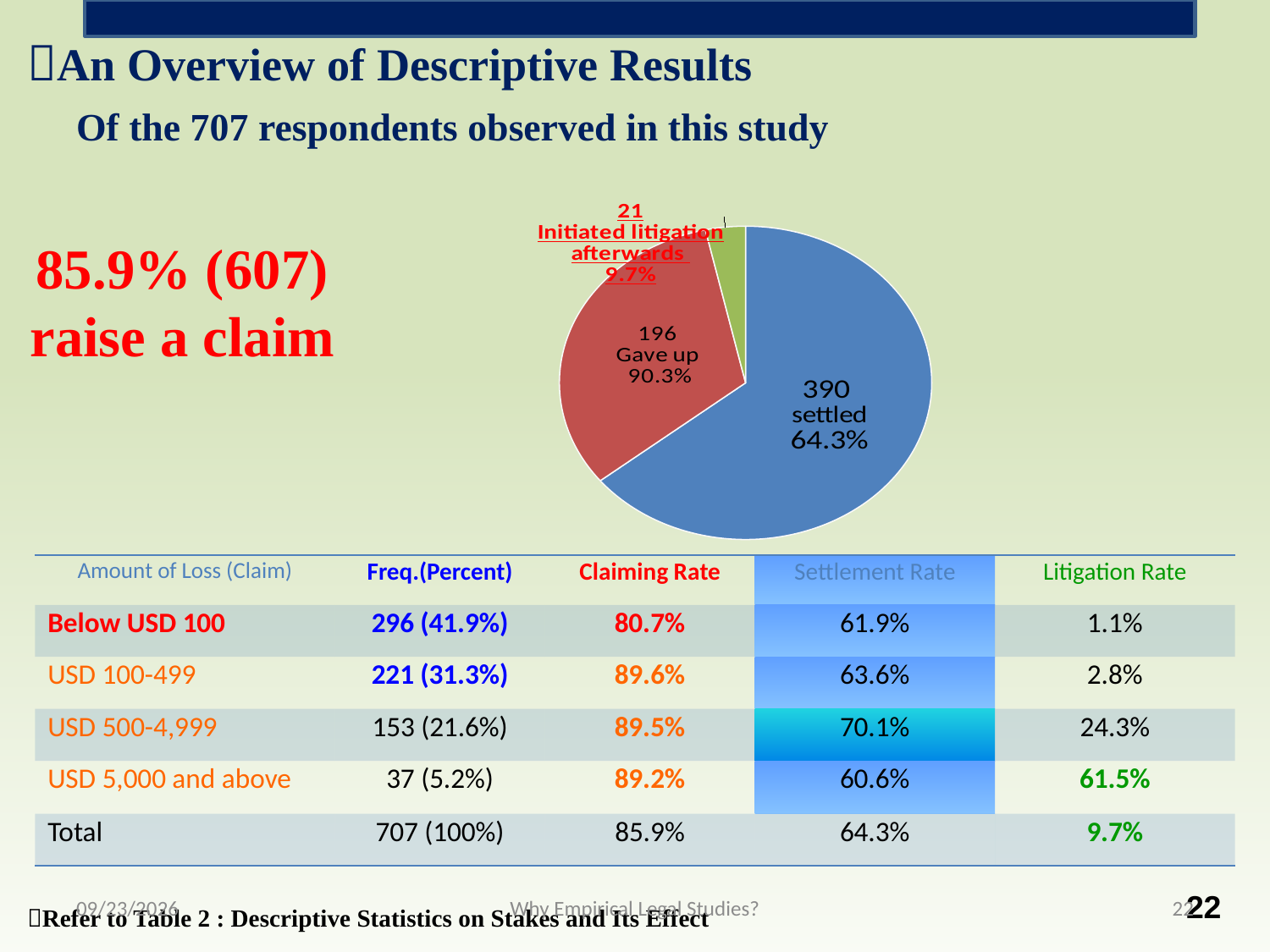
How many respondents are in the 'Gave up' slice of the pie chart? 196 What percentage is printed on the 'settled' slice of the pie chart? 64.3% In the pie chart, how many more respondents are in 'settled' than in 'Gave up'? 194 Which slice of the pie chart is the largest? settled In the pie chart, which has more respondents: 'settled' or 'Gave up'? settled What kind of chart is shown on the slide? pie chart What percentage is printed on the 'Initiated litigation afterwards' slice of the pie chart? 9.7% What colour is the 'settled' slice of the pie chart? blue Which slice of the pie chart is the smallest? Initiated litigation afterwards How many respondents are in the 'settled' slice of the pie chart? 390 How many respondents are in the 'Initiated litigation afterwards' slice of the pie chart? 21 How many slices does the pie chart have? 3